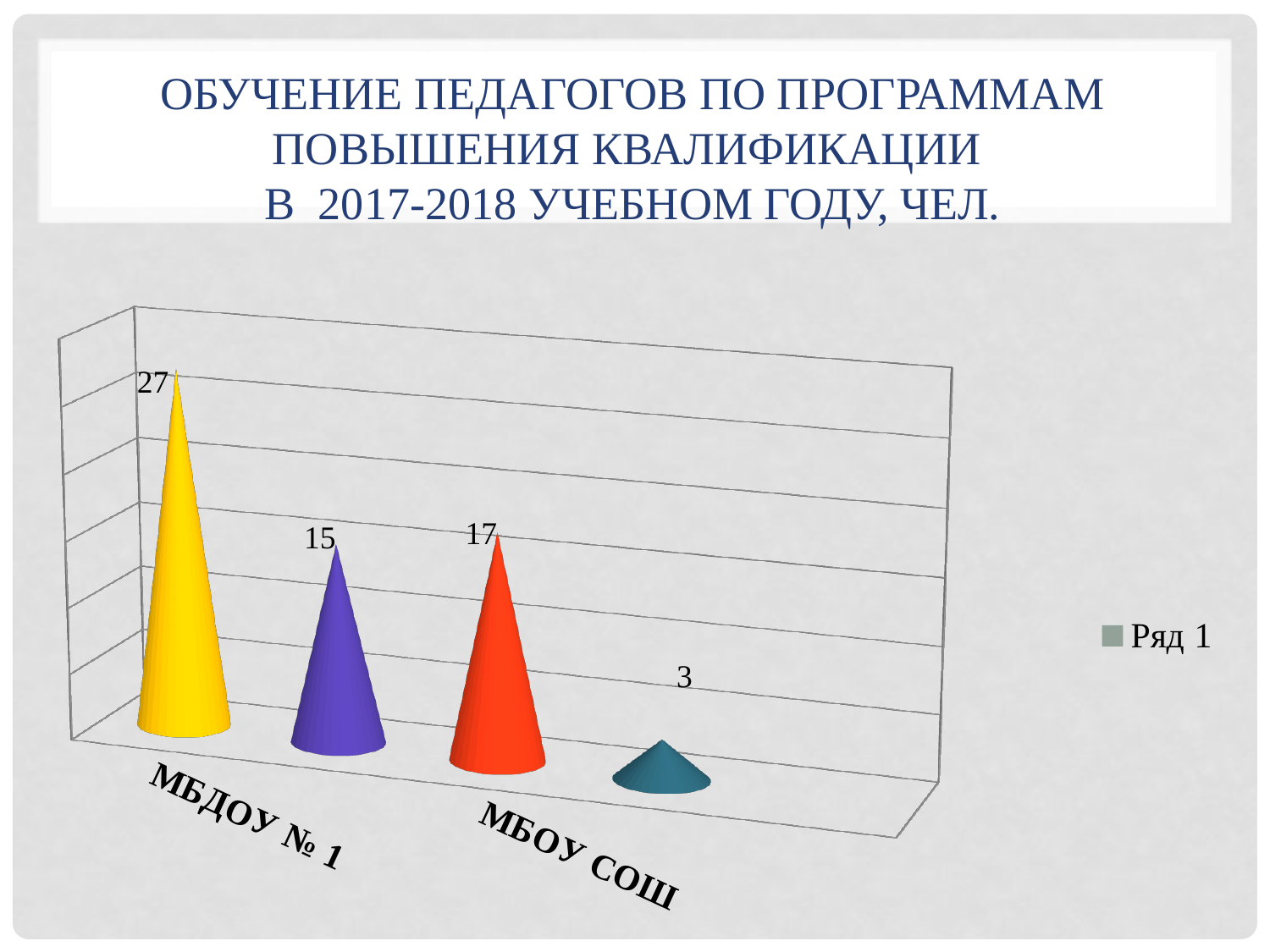
What is the value for МБОУ СОШ? 17 What is the value for МБДОУ № 1? 27 How many series does the legend list? 1 What unit is stated in the slide title for the values? чел. What is the difference between the values for МБДОУ № 1 and МБОУ СОШ? 10 How many bars are plotted on the chart? 4 What is the smallest value shown on the chart? 3 Which labelled category has the highest value? МБДОУ № 1 What kind of chart is shown on the slide? bar chart What is the name of the series shown in the legend? Ряд 1 What is the largest value shown on the chart? 27 Which is larger, the value for МБДОУ № 1 or the value for МБОУ СОШ? МБДОУ № 1